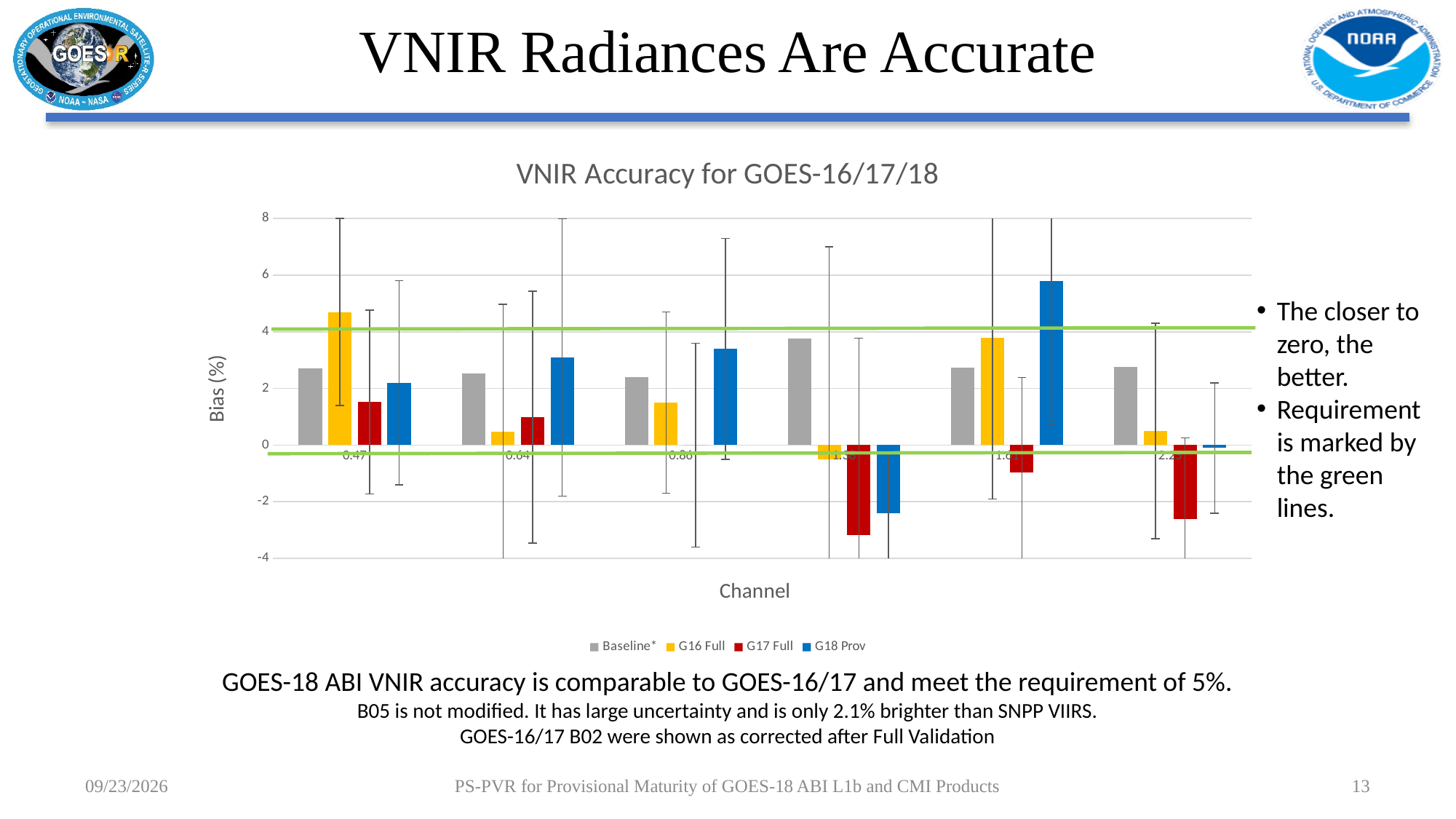
Is the G18 Prov value for channel 0.86 greater or less than 2? greater What is the title of the vertical axis of the chart? Bias (%) How many series does the legend of the VNIR Accuracy chart list? 4 For channel 0.47, which series has the highest bar? G16 Full Is the G16 Full value for channel 0.47 greater or less than 4? greater For channel 0.64, which series has the lowest bar? G16 Full How many channel groups are plotted along the x axis of the chart? 6 Is the G18 Prov value for channel 0.64 greater or less than 2? greater What kind of chart is shown on the slide? bar chart For channel 0.47, which is larger: the G16 Full value or the G17 Full value? G16 Full What are the series names listed in the legend of the chart? Baseline*, G16 Full, G17 Full, G18 Prov